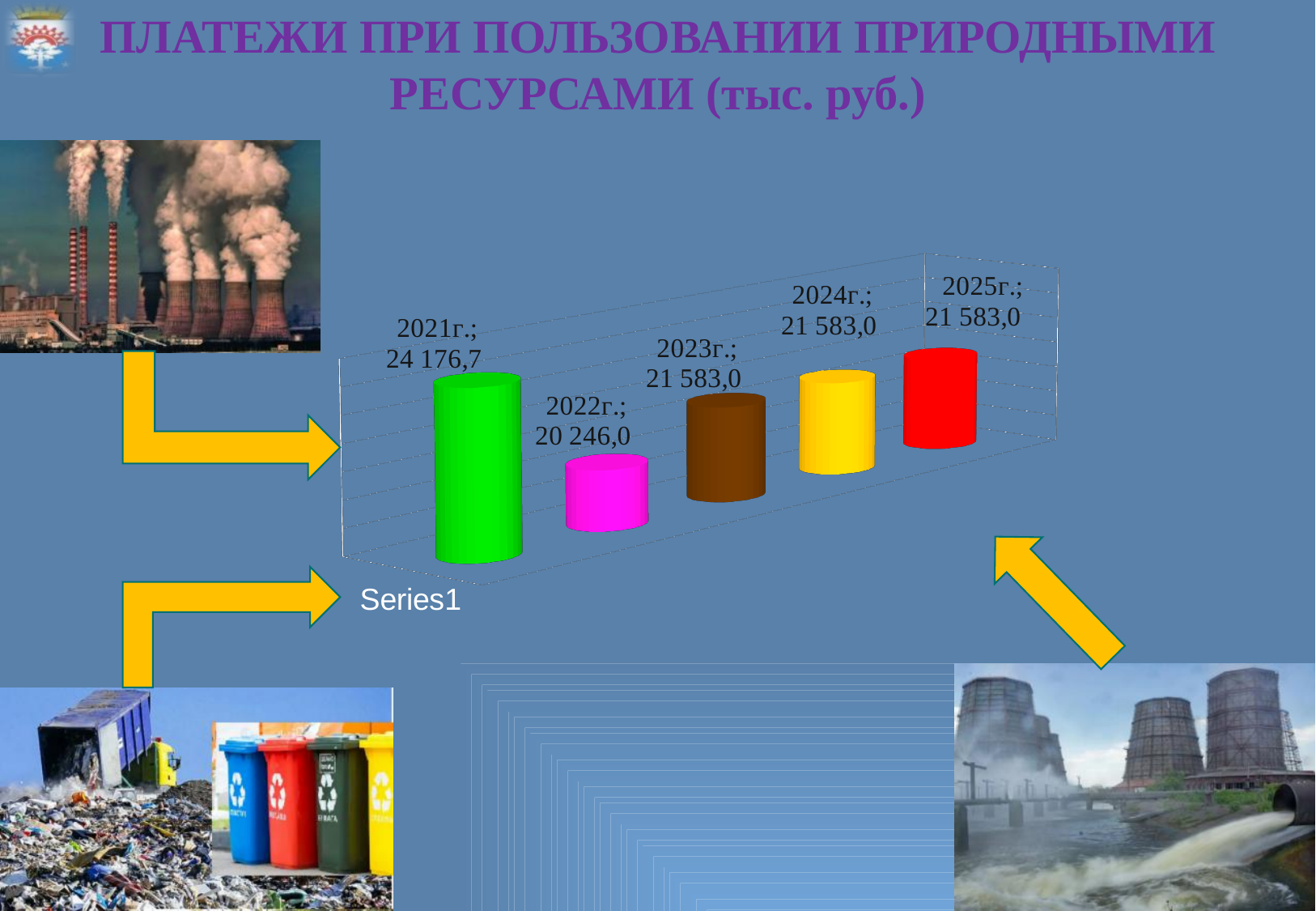
Which year has the lowest value? 2022г. What is the difference between the values for 2023г. and 2022г.? 1 337,0 What kind of chart is shown on the slide? Bar chart What is the value for 2024г.? 21 583,0 Does the value rise or fall from 2021г. to 2022г.? Fall Which year has the highest value? 2021г. What is the value for 2022г.? 20 246,0 What is the value for 2021г.? 24 176,7 How many years are shown in the chart? 5 What colour is the bar for 2021г.? Green Which is larger, the value for 2021г. or the value for 2025г.? 2021г. What is the difference between the values for 2021г. and 2022г.? 3 930,7